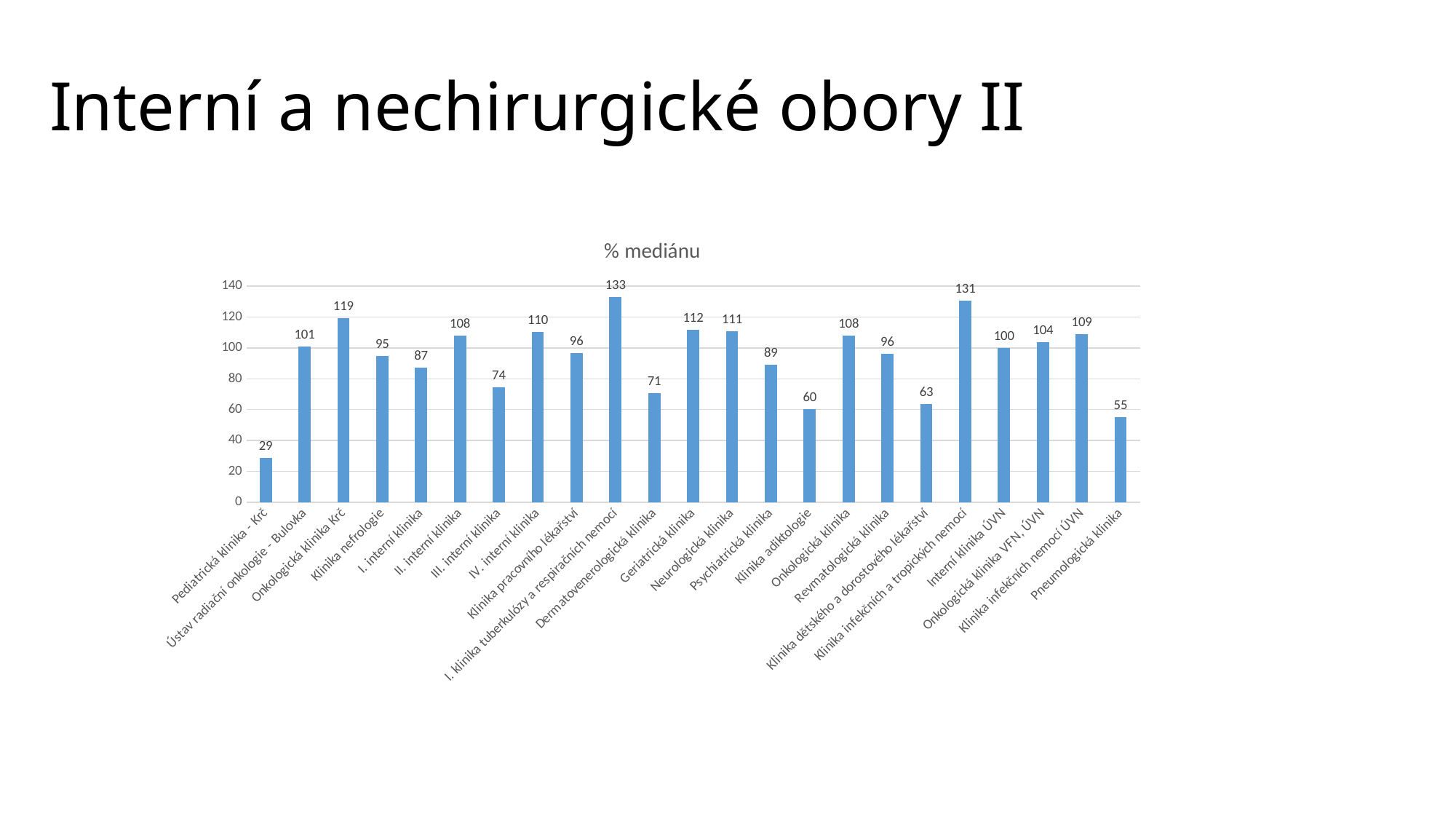
What is the difference between the values for Geriatrická klinika and Psychiatrická klinika? 23 What is the value for Klinika adiktologie? 60 What is the value for Onkologická klinika Krč? 119 Is the value for Dermatovenerologická klinika greater or less than 80? less What kind of chart is shown on the slide? bar chart Which category has the highest value? I. klinika tuberkulózy a respiračních nemocí Which category has the lowest value? Pediatrická klinika - Krč How many categories are shown on the x axis? 23 Which is larger, the value for IV. interní klinika or the value for III. interní klinika? IV. interní klinika What is the value for Pneumologická klinika? 55 What is the difference between the values for Klinika infekčních a tropických nemocí and Klinika infekčních nemocí ÚVN? 22 What is the title of the chart? % mediánu